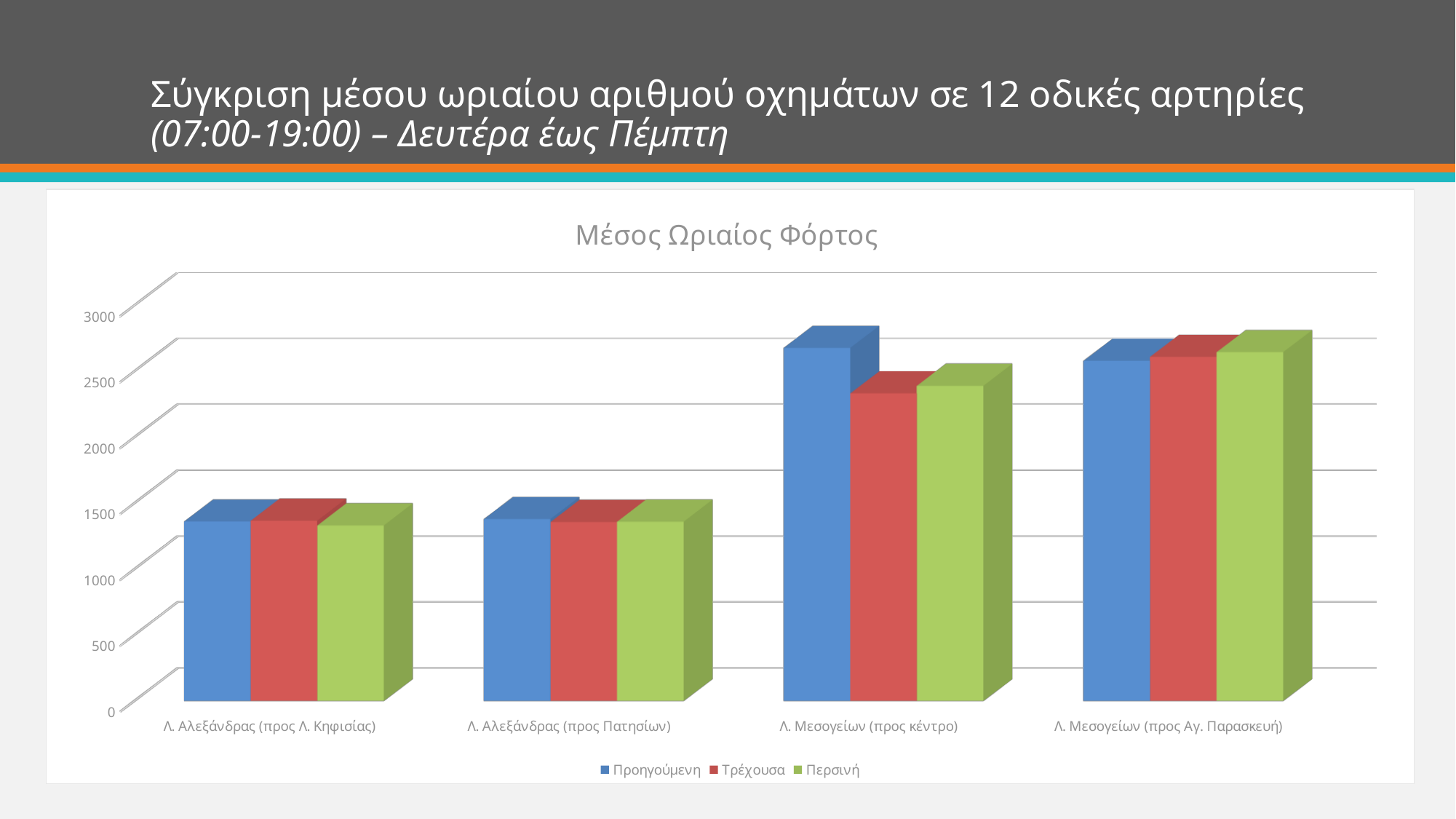
How many road categories are shown on the x axis of the chart? 4 Is the Τρέχουσα value for Λ. Αλεξάνδρας (προς Πατησίων) greater or less than 1000? greater Which series is shown in red in the chart? Τρέχουσα What is the title of the chart? Μέσος Ωριαίος Φόρτος For Λ. Μεσογείων (προς κέντρο), which is larger: the Προηγούμενη value or the Τρέχουσα value? Προηγούμενη Is the Περσινή value for Λ. Μεσογείων (προς Αγ. Παρασκευή) greater or less than 2000? greater Is the Προηγούμενη value for Λ. Μεσογείων (προς κέντρο) greater or less than 2500? greater For the Τρέχουσα series, which is larger: Λ. Μεσογείων (προς κέντρο) or Λ. Αλεξάνδρας (προς Λ. Κηφισίας)? Λ. Μεσογείων (προς κέντρο) What kind of chart is shown on the slide? Bar chart For Λ. Μεσογείων (προς κέντρο), which series has the highest value? Προηγούμενη How many series does the chart legend list? 3